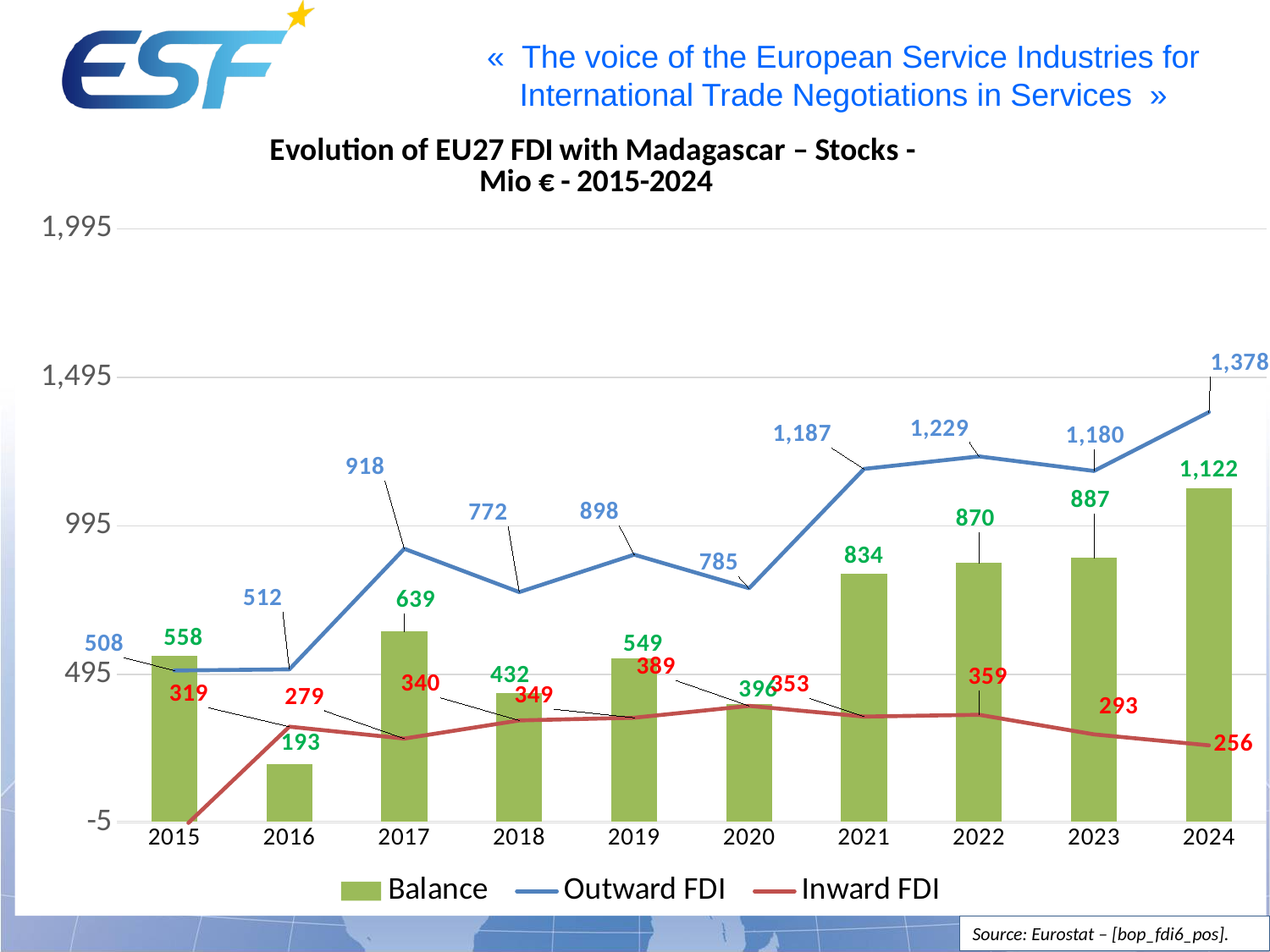
What is the Balance value for 2024? 1,122 How many years are shown on the x axis? 10 In which year is the Balance lowest? 2016 How many series does the legend list? 3 What is the difference between the Balance in 2024 and in 2023? 235 What is the Outward FDI value for 2017? 918 What is the Outward FDI value for 2020? 785 What is the Inward FDI value for 2024? 256 Which year has the larger Outward FDI, 2021 or 2022? 2022 What kind of chart is shown on the slide? A combined bar and line chart In which year is Outward FDI highest? 2024 Does the Balance rise or fall from 2021 to 2024? Rise